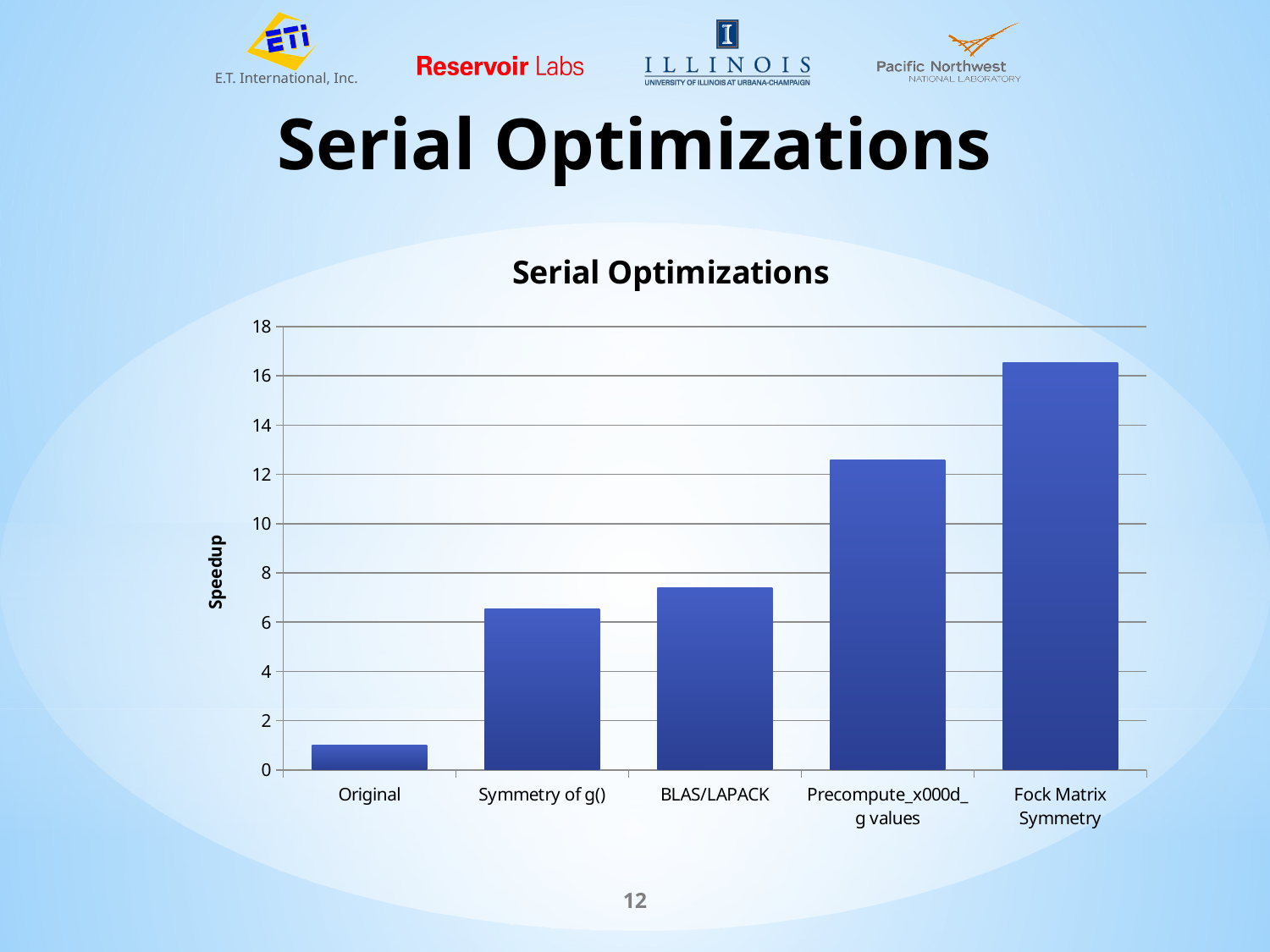
Which is larger, the speedup for BLAS/LAPACK or for Precompute_x000d_g values? Precompute_x000d_g values Is the value for Symmetry of g() greater or less than 6? greater What kind of chart is shown on the slide? bar chart How many categories are shown on the x axis of the chart? 5 Which category has the lowest speedup? Original Is the value for Fock Matrix Symmetry greater or less than 16? greater What is the label on the vertical axis of the chart? Speedup Is the value for Original greater or less than 2? less Which category has the highest speedup? Fock Matrix Symmetry Do the speedup values rise or fall from left to right along the x axis? rise